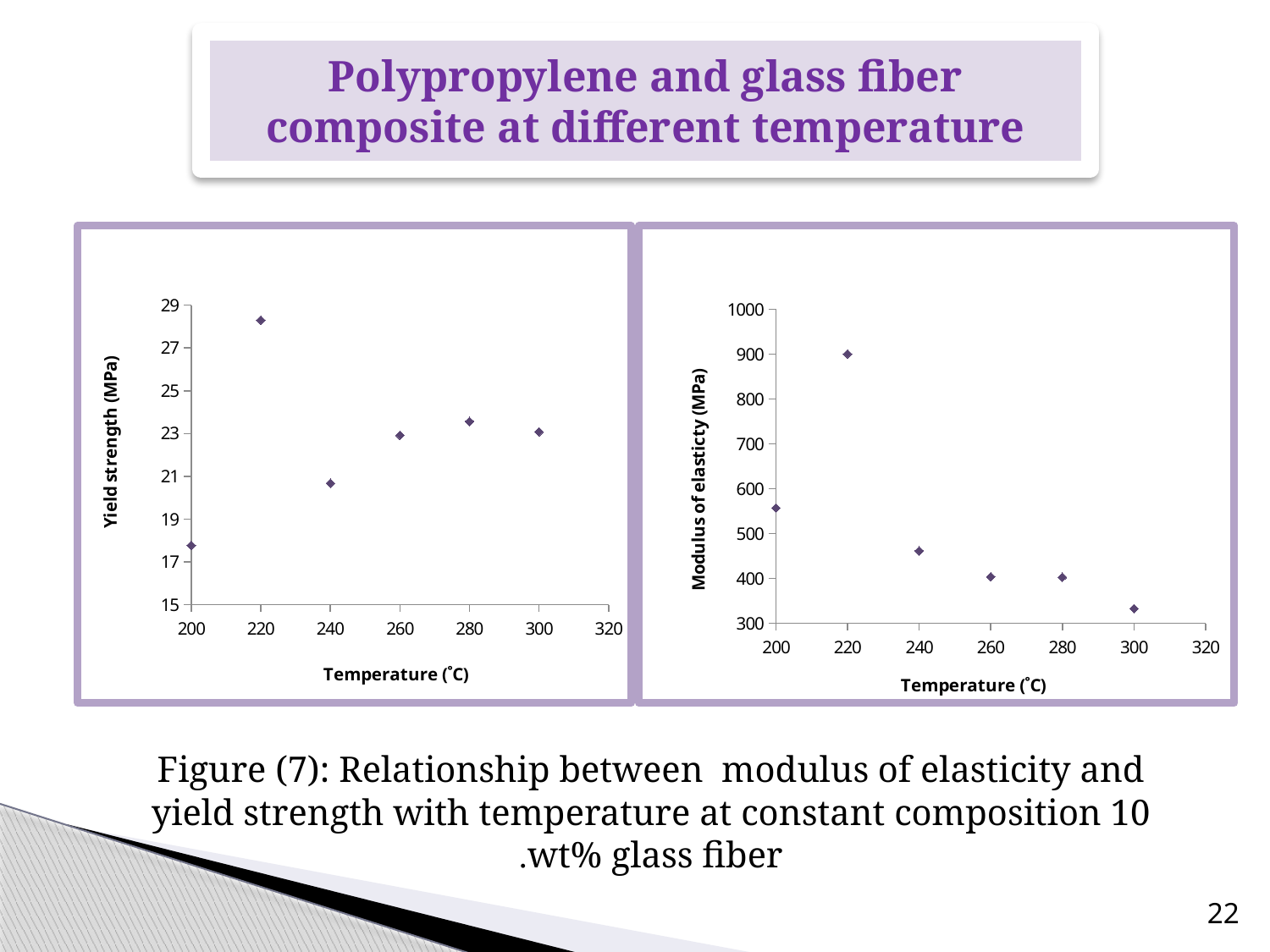
In the left chart (Yield strength), at which temperature is the yield strength highest? 220 In the right chart (Modulus of elasticity), which is larger, the value at 200 °C or at 240 °C? 200 °C In the left chart (Yield strength), how many data points are plotted? 6 In the left chart (Yield strength), is the value at 200 °C greater or less than 19? less In the left chart (Yield strength), which is larger, the value at 240 °C or at 260 °C? 260 °C What kind of chart is the left chart, Yield strength vs Temperature? scatter chart In the right chart (Modulus of elasticity), at which temperature is the modulus lowest? 300 In the right chart (Modulus of elasticity), is the value at 300 °C greater or less than 400? less In the left chart (Yield strength), is the value at 220 °C greater or less than 27? greater What is the y-axis title of the right chart? Modulus of elasticty (MPa) In the right chart (Modulus of elasticity), at which temperature is the modulus highest? 220 In the left chart (Yield strength), at which temperature is the yield strength lowest? 200